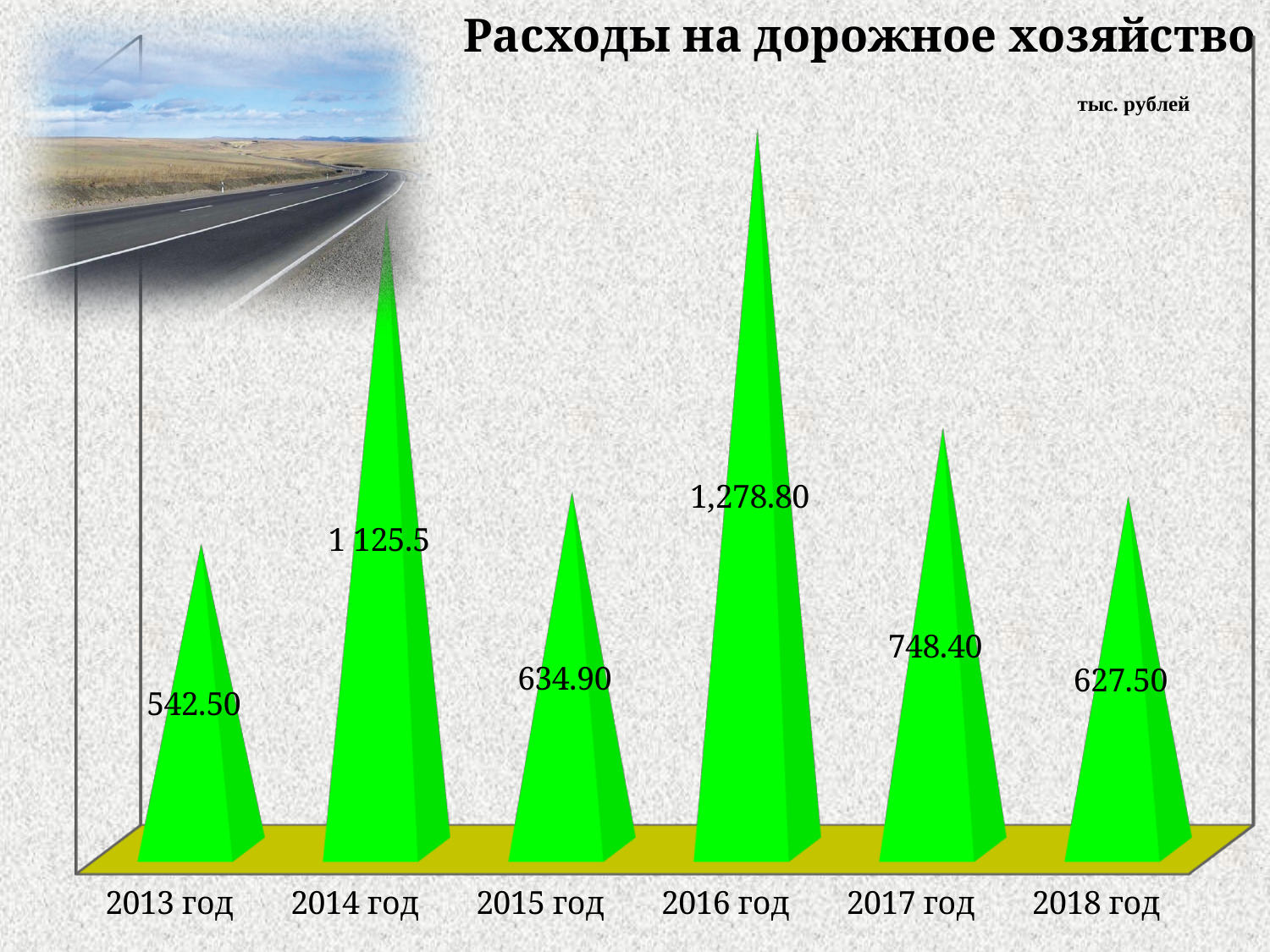
What is the value for 2017 год? 748.40 What is the value for 2016 год? 1,278.80 How many years are shown on the chart? 6 Which year has the highest value? 2016 год What is the difference between the values for 2016 год and 2013 год? 736.30 Which year has the lowest value? 2013 год What is the value for 2014 год? 1 125.5 Which is larger, the value for 2014 год or the value for 2017 год? 2014 год What is the value for 2013 год? 542.50 What is the title of the chart? Расходы на дорожное хозяйство What is the difference between the values for 2017 год and 2018 год? 120.90 What kind of chart is shown on the slide? bar chart